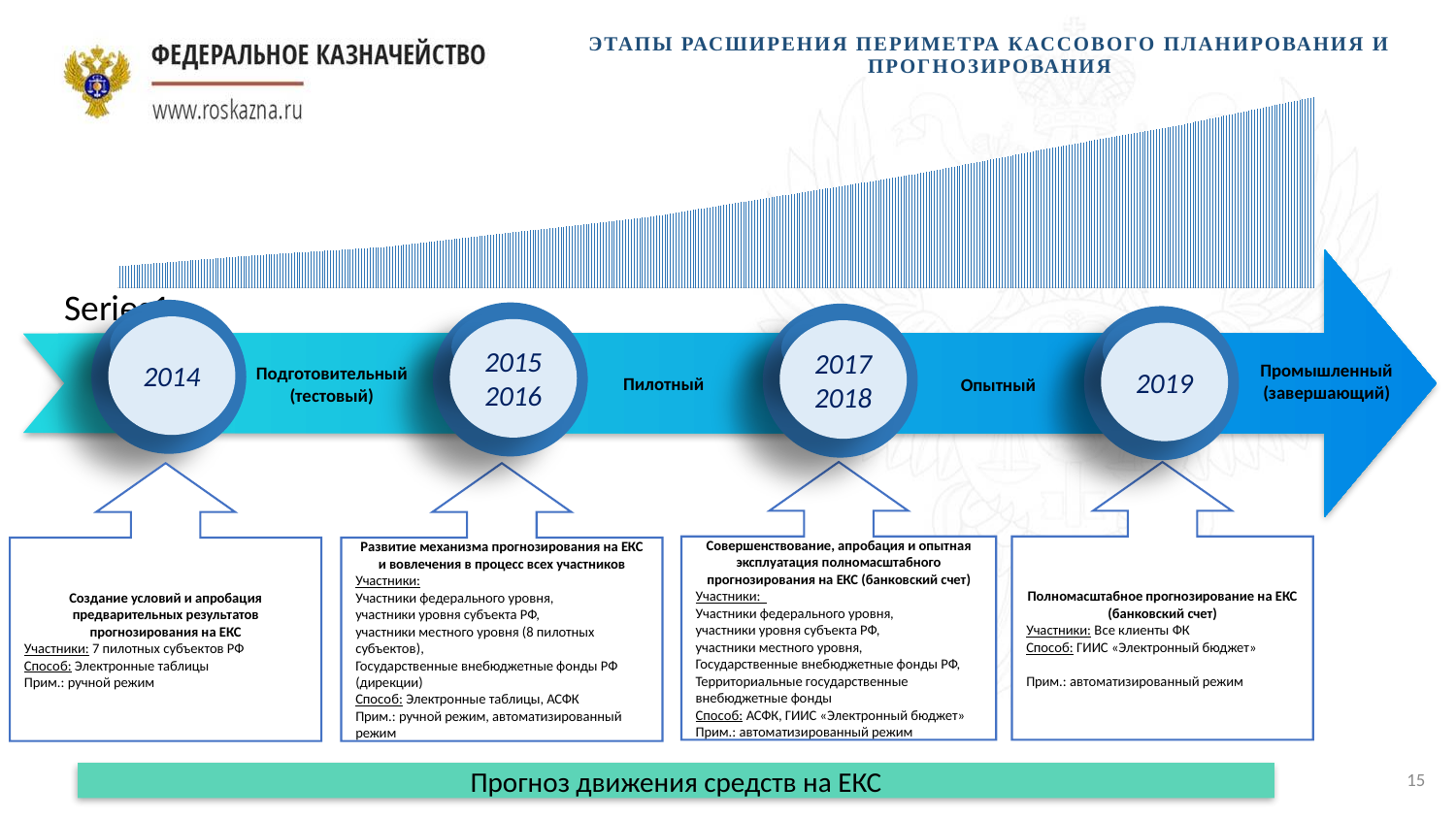
What kind of chart is shown in the upper part of the slide, above the timeline arrow? area chart In the bar chart above the timeline arrow, do the bar heights rise or fall from left to right? rise What colour are the bars in the bar chart above the timeline arrow? blue